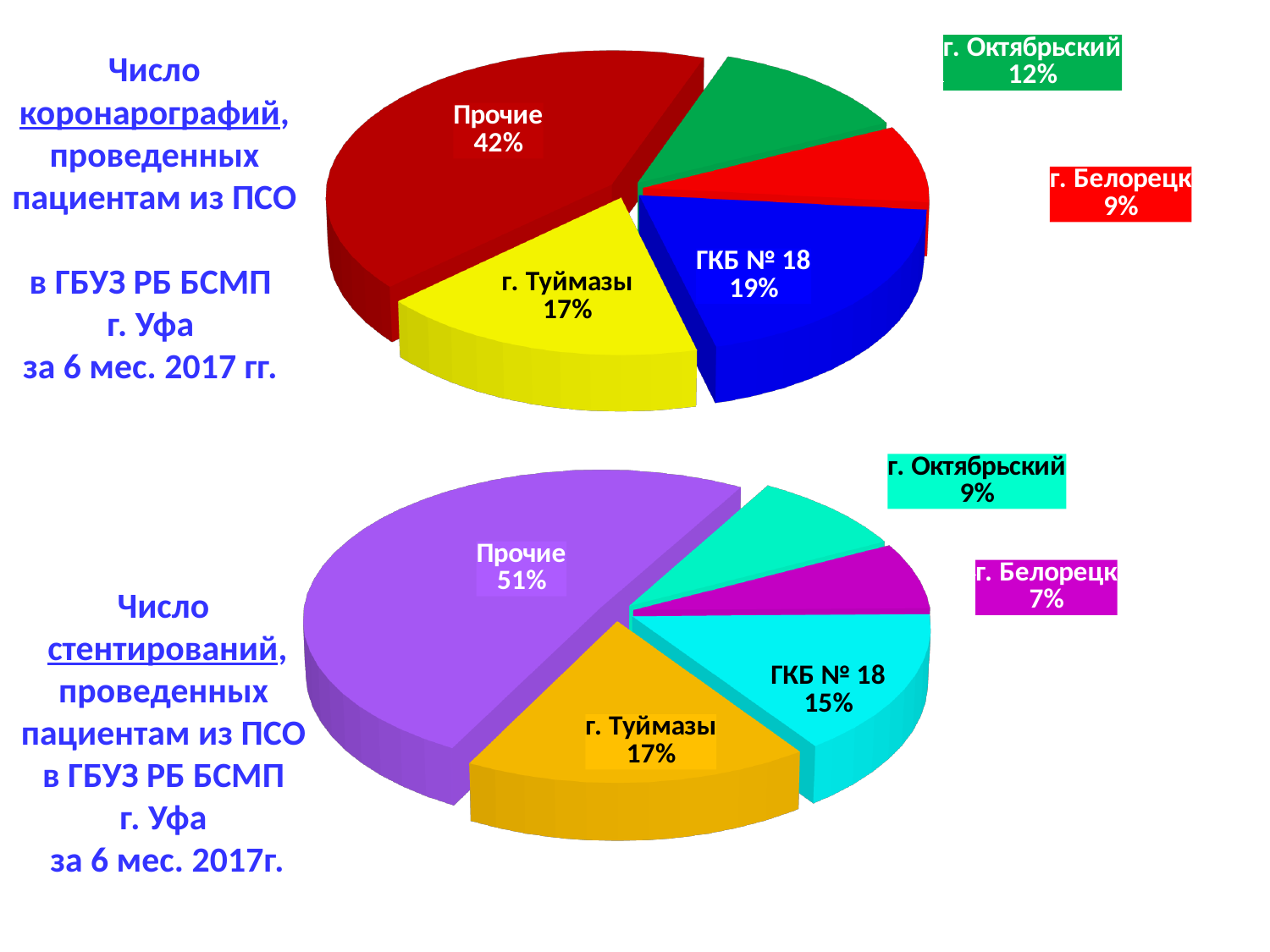
In the top chart (number of coronarographies), which category has the smallest share? г. Белорецк In the bottom chart (number of stentings), which category has the largest share? Прочие In the bottom chart (number of stentings), what share does Прочие have? 51% In the top chart (number of coronarographies), what share does ГКБ № 18 have? 19% In the top chart (number of coronarographies), what colour is the Прочие slice? Dark red In the top chart (number of coronarographies), how many slices does the pie have? 5 In the bottom chart (number of stentings), what share does г. Белорецк have? 7% In the bottom chart (number of stentings), which is larger: the share of г. Туймазы or the share of ГКБ № 18? г. Туймазы In the top chart (number of coronarographies), what share does Прочие have? 42% In the top chart (number of coronarographies), what is the difference between the shares of г. Октябрьский and г. Белорецк? 3% What type of chart is used for both charts on the slide? Pie chart In the bottom chart (number of stentings), what is the difference between the shares of ГКБ № 18 and г. Октябрьский? 6%